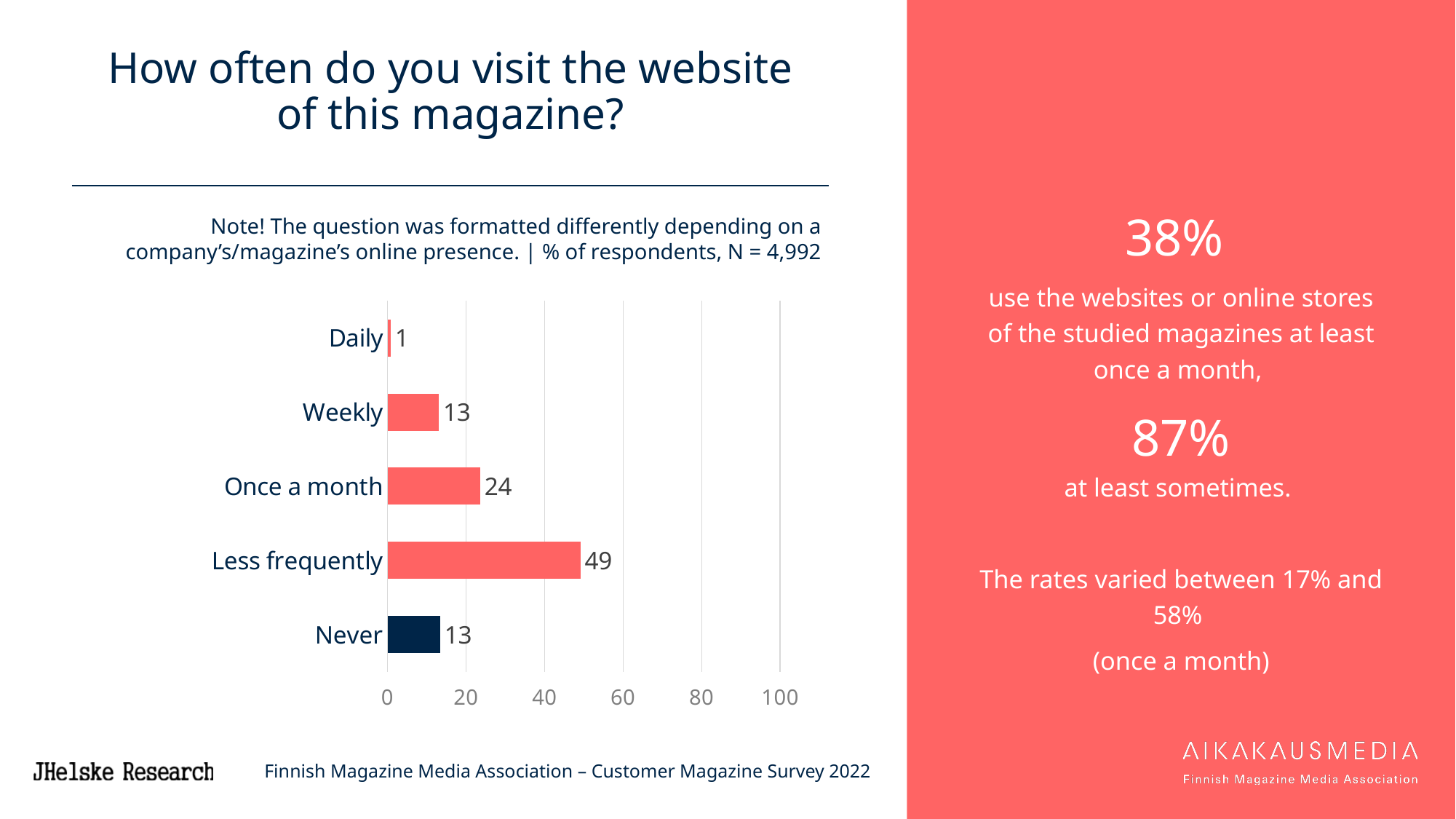
Which category has the highest value? Less frequently Is the value for 'Less frequently' greater or less than 40? greater What is the total of the values for 'Weekly' and 'Never'? 26 What kind of chart is shown on the slide? Bar chart Which is larger, the value for 'Weekly' or the value for 'Once a month'? Once a month What is the difference between the values for 'Less frequently' and 'Once a month'? 25 How many categories are shown in the chart? 5 What is the value for 'Once a month'? 24 Which category's bar is coloured dark navy instead of coral? Never Which category has the lowest value? Daily What is the value for 'Less frequently'? 49 What percentage of respondents visit the magazine's website daily? 1